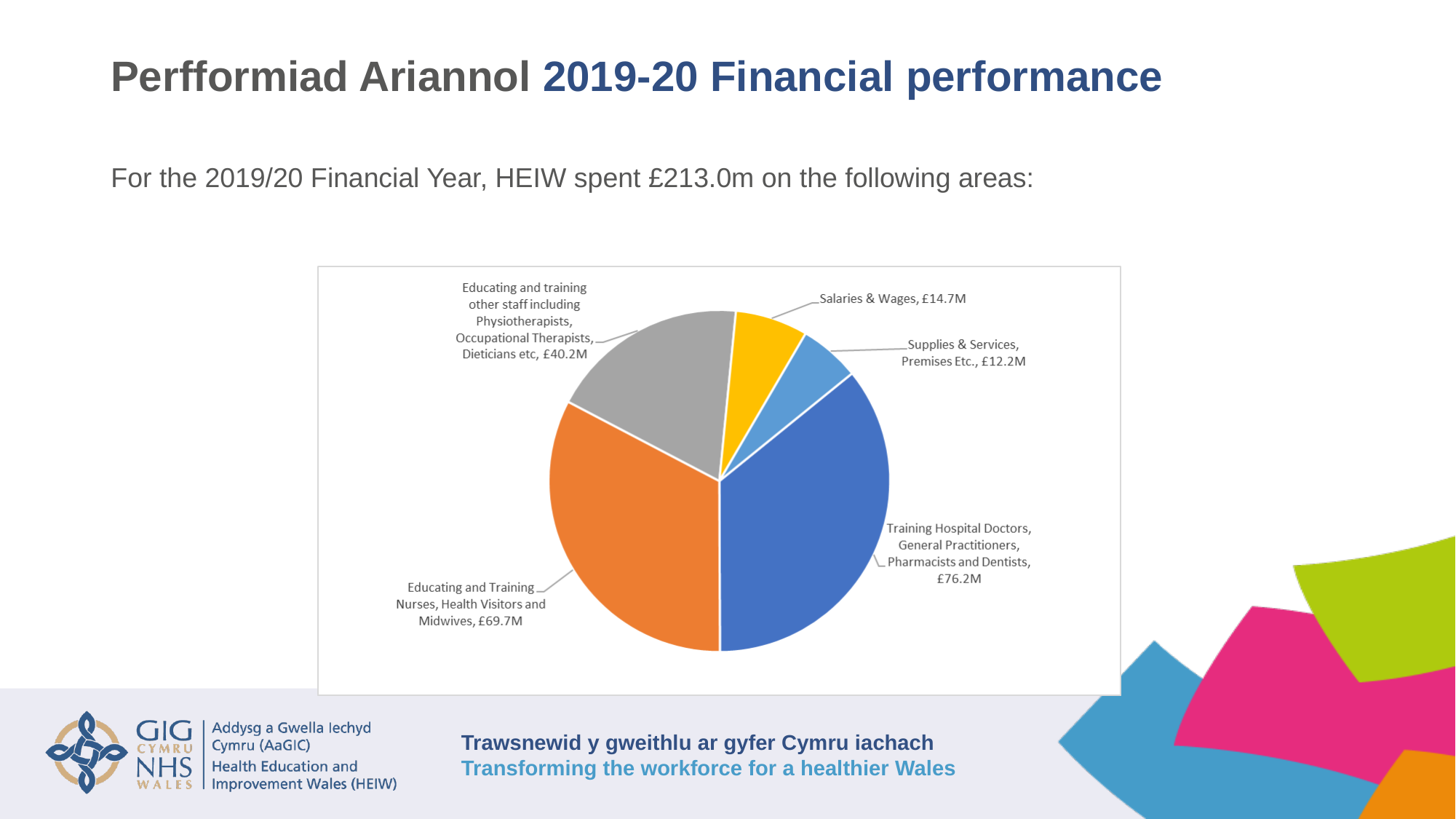
What is the value for Supplies & Services, Premises Etc.? £12.2M How much was spent on Training Hospital Doctors, General Practitioners, Pharmacists and Dentists? £76.2M What colour is the slice for Salaries & Wages? Yellow Which is larger: spending on Educating and training other staff including Physiotherapists, Occupational Therapists, Dieticians etc, or Salaries & Wages? Educating and training other staff including Physiotherapists, Occupational Therapists, Dieticians etc What is the difference between spending on Training Hospital Doctors, General Practitioners, Pharmacists and Dentists and spending on Educating and Training Nurses, Health Visitors and Midwives? £6.5M What kind of chart is shown on the slide? Pie chart What is the value for Salaries & Wages? £14.7M Which spending area has the smallest slice of the pie? Supplies & Services, Premises Etc. How much was spent on Educating and Training Nurses, Health Visitors and Midwives? £69.7M What is the difference between Salaries & Wages and Supplies & Services, Premises Etc.? £2.5M Which spending area has the largest slice of the pie? Training Hospital Doctors, General Practitioners, Pharmacists and Dentists How many spending areas are shown in the pie chart? 5